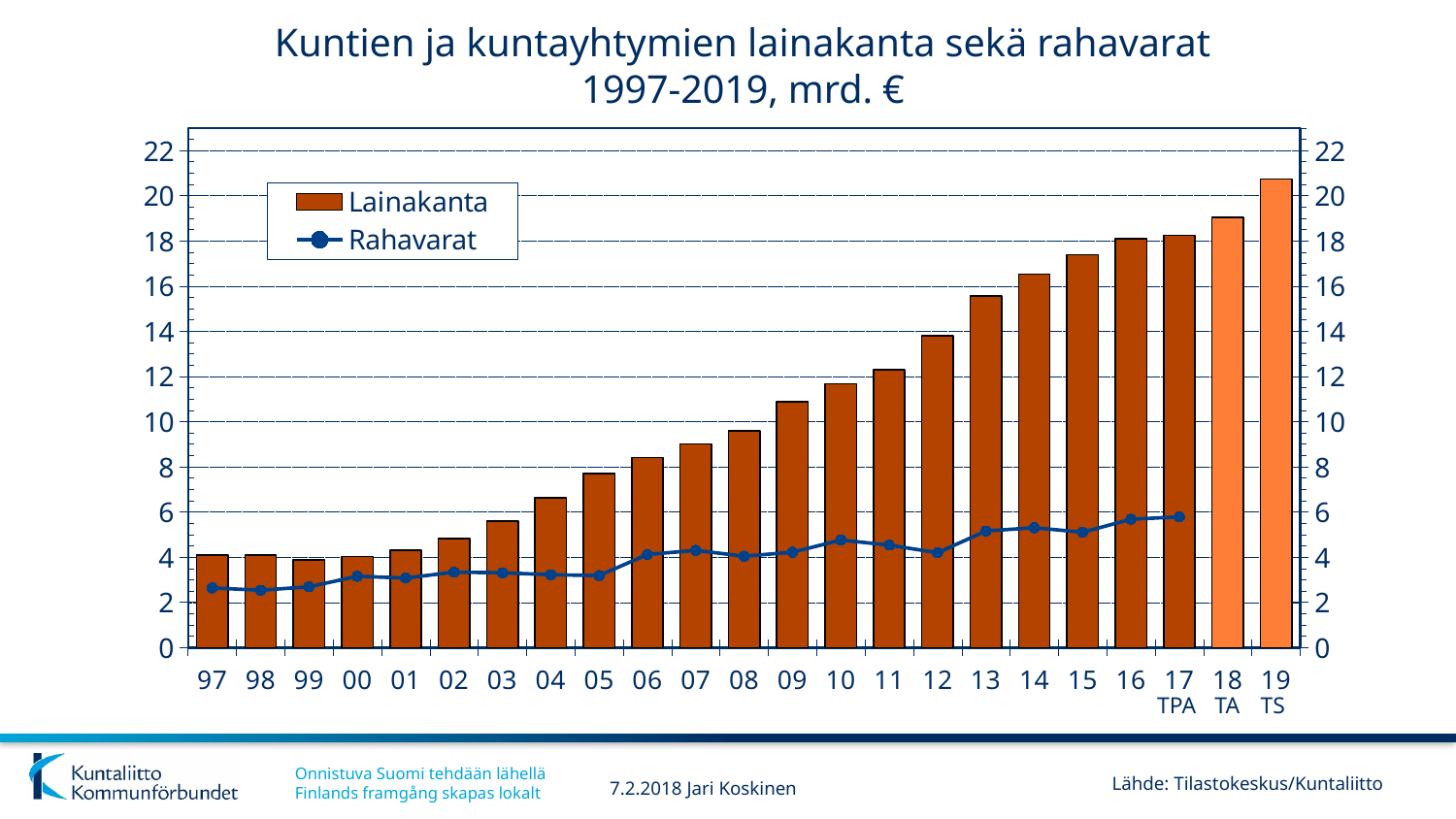
Is the Lainakanta value for 13 greater or less than 14? greater Which is larger, the Rahavarat value for 12 or for 14? 14 Which is larger, the Lainakanta value for 12 or for 13? 13 How many series does the legend list? 2 How many years (bars) are shown along the x axis? 23 Is the Lainakanta value for 10 greater or less than 12? less Is the Lainakanta value for 19 greater or less than 20? greater What kind of chart is shown on the slide? A combined bar and line chart Do the Lainakanta values generally rise or fall from 97 to 19? rise Which year has the highest Lainakanta bar? 19 What are the two series named in the legend? Lainakanta and Rahavarat